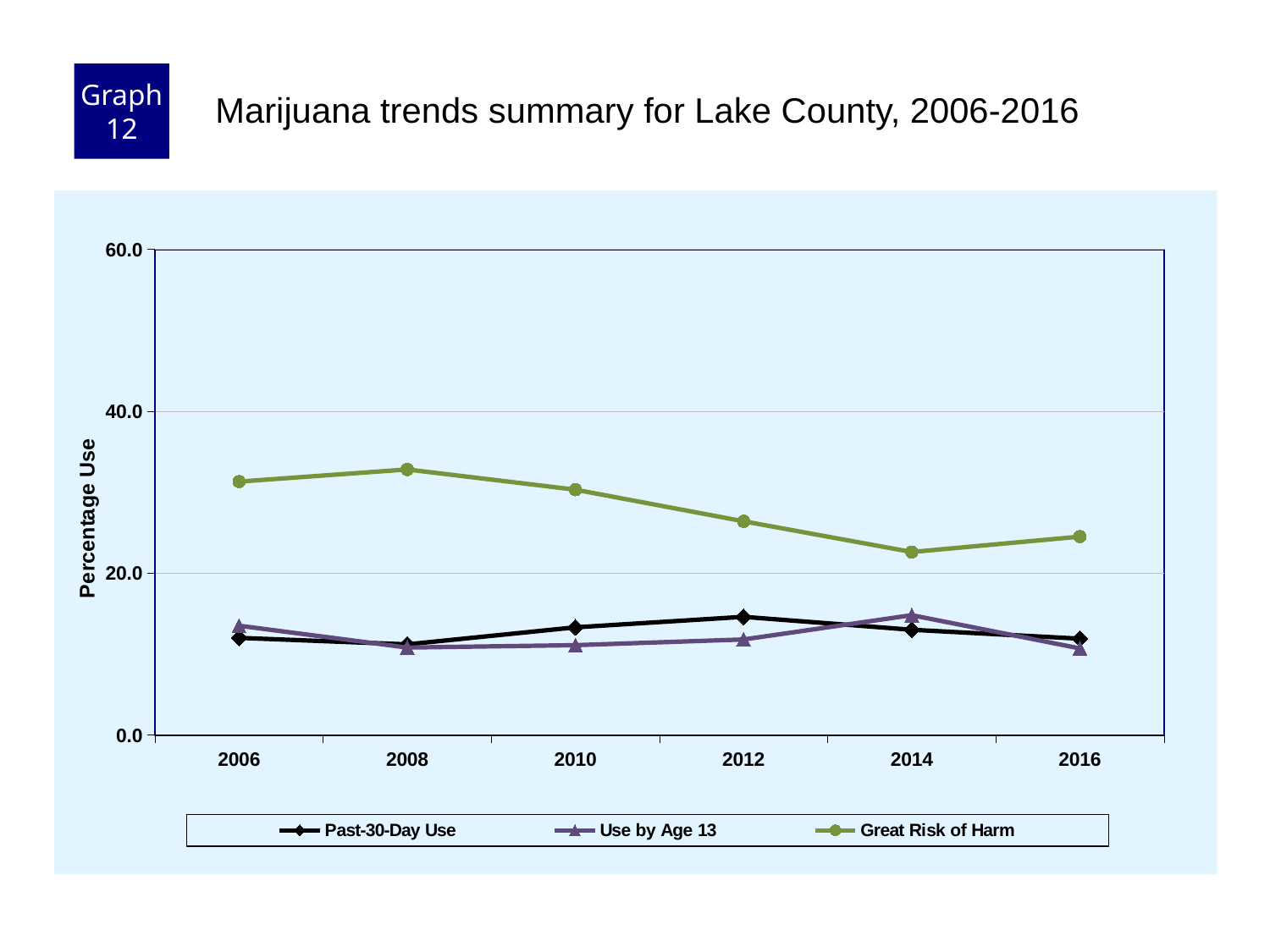
In 2014, which is higher: Past-30-Day Use or Use by Age 13? Use by Age 13 In which year is Great Risk of Harm at its lowest? 2014 In which year is Use by Age 13 at its highest? 2014 In which year is Great Risk of Harm at its highest? 2008 What is the label on the y axis? Percentage Use What kind of chart is shown on the slide? Line chart Is the value for Great Risk of Harm in 2014 greater or less than 20.0? greater Does Great Risk of Harm rise or fall from 2008 to 2014? Fall Is the value for Past-30-Day Use in 2012 greater or less than 20.0? less How many series does the legend list? 3 Is the value for Great Risk of Harm in 2008 greater or less than 40.0? less How many years are plotted along the x axis? 6